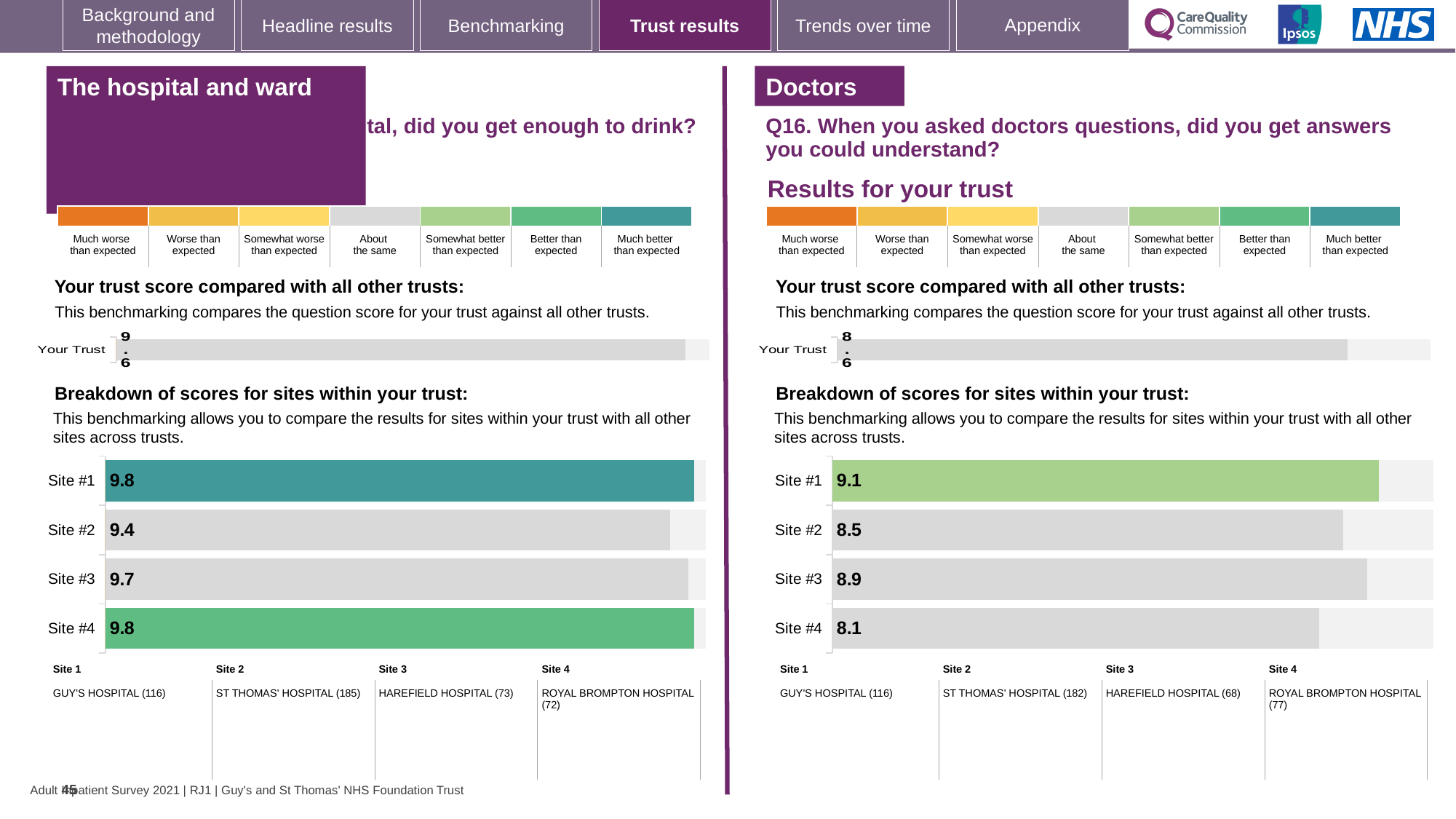
In the left-hand site breakdown chart (The hospital and ward section), what is the score for Site #3? 9.7 In the right-hand site breakdown chart (Doctors, Q16), which has the larger score, Site #2 or Site #3? Site #3 In the left-hand site breakdown chart (The hospital and ward section), what is the score for Site #2? 9.4 In the right-hand site breakdown chart (Doctors, Q16), what is the score for Site #4? 8.1 In the left-hand site breakdown chart (The hospital and ward section), which site has the lowest score? Site #2 In the right-hand site breakdown chart (Doctors, Q16), what is the difference between the scores for Site #1 and Site #4? 1.0 In the right-hand site breakdown chart (Doctors, Q16), which site has the lowest score? Site #4 What type of chart is used for the site breakdown in the Doctors (Q16) section? Bar chart In the right-hand site breakdown chart (Doctors, Q16), what is the score for Site #1? 9.1 In the right-hand site breakdown chart (Doctors, Q16), which site has the highest score? Site #1 In the left-hand site breakdown chart (The hospital and ward section), what is the difference between the scores for Site #3 and Site #2? 0.3 How many sites are shown in the left-hand site breakdown chart (The hospital and ward section)? 4